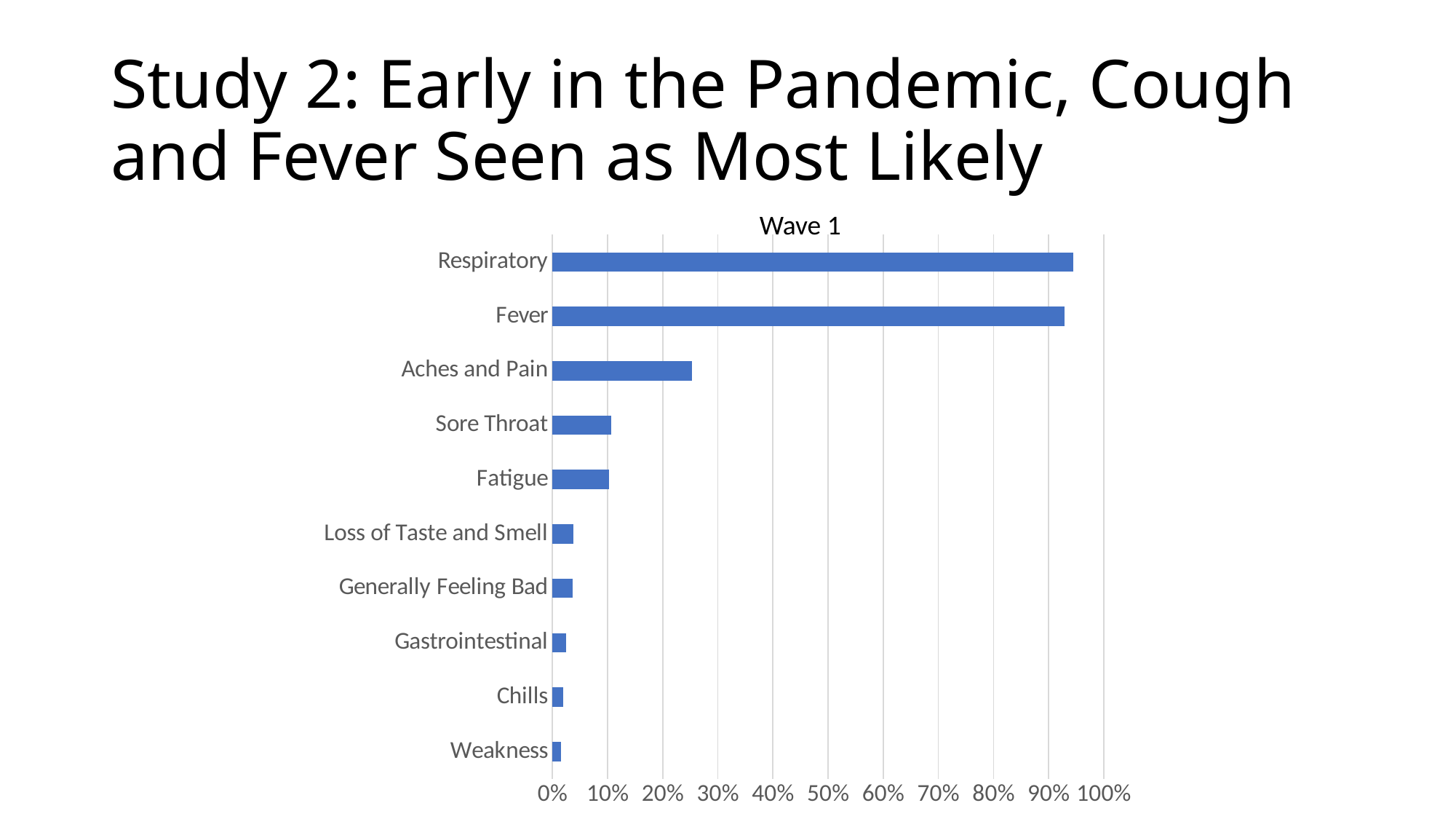
How many symptom categories are plotted in the chart? 10 What is the title of the chart? Wave 1 Which has a larger value, Aches and Pain or Sore Throat? Aches and Pain Which has a larger value, Respiratory or Aches and Pain? Respiratory Is the value for Aches and Pain greater or less than 20%? greater What kind of chart is shown on the slide? bar chart Which category is listed at the top of the chart? Respiratory Is the value for Aches and Pain greater or less than 30%? less Which has a larger value, Fever or Fatigue? Fever Is the value for Respiratory greater or less than 90%? greater